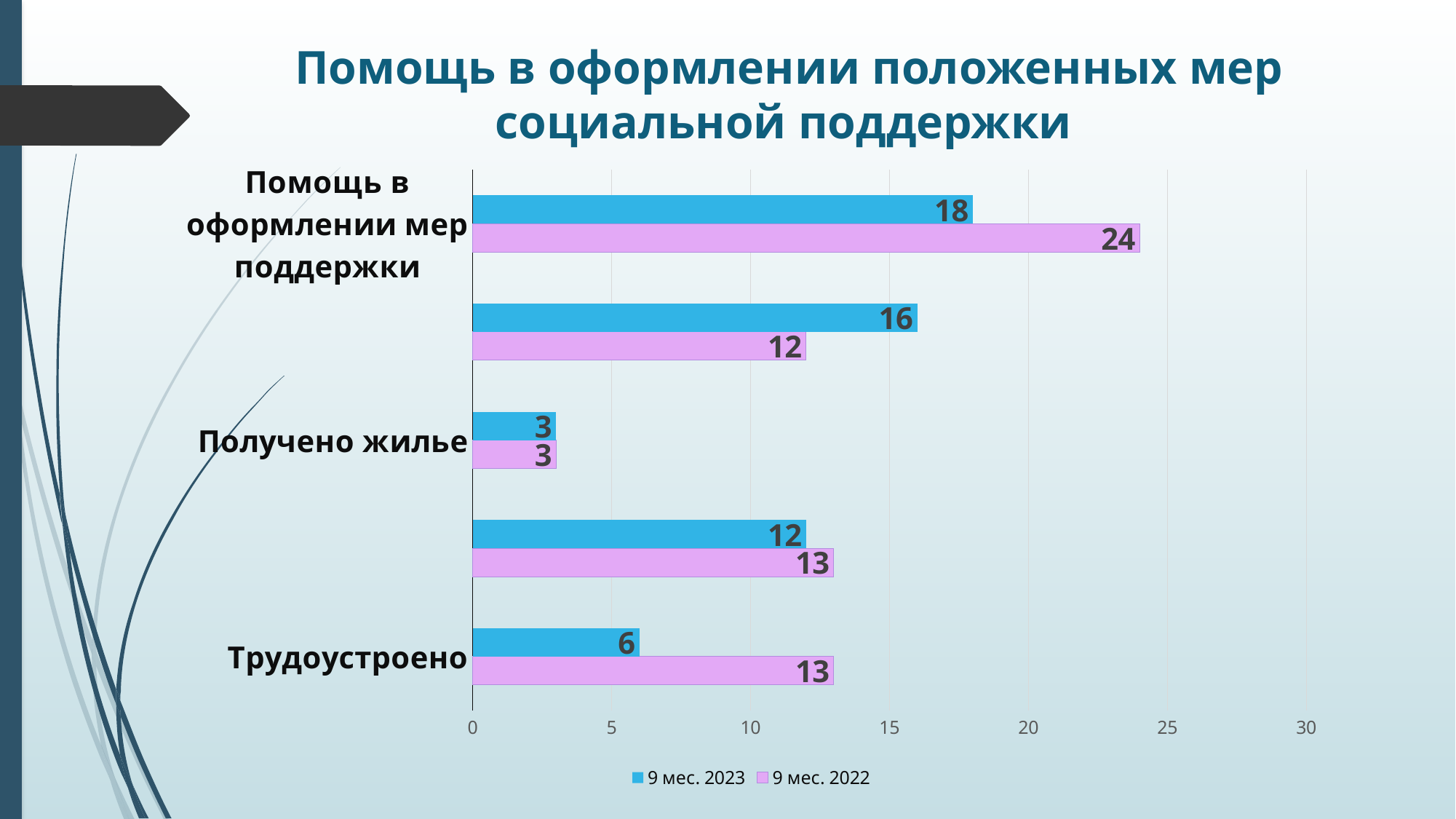
What is the value for "Получено жилье" in the "9 мес. 2023" series? 3 What is the title of the chart? Помощь в оформлении положенных мер социальной поддержки How many series does the legend list? 2 What is the value for "Помощь в оформлении мер поддержки" in the "9 мес. 2022" series? 24 For "Трудоустроено", which series has the larger value, "9 мес. 2023" or "9 мес. 2022"? 9 мес. 2022 Which category has the highest value in the "9 мес. 2022" series? Помощь в оформлении мер поддержки What type of chart is shown on the slide? Bar chart What is the value for "Помощь в оформлении мер поддержки" in the "9 мес. 2023" series? 18 Which category has the lowest value in the "9 мес. 2023" series? Получено жилье What is the difference between the "9 мес. 2022" and "9 мес. 2023" values for "Трудоустроено"? 7 What is the difference between the "9 мес. 2022" and "9 мес. 2023" values for "Помощь в оформлении мер поддержки"? 6 What is the value for "Трудоустроено" in the "9 мес. 2022" series? 13